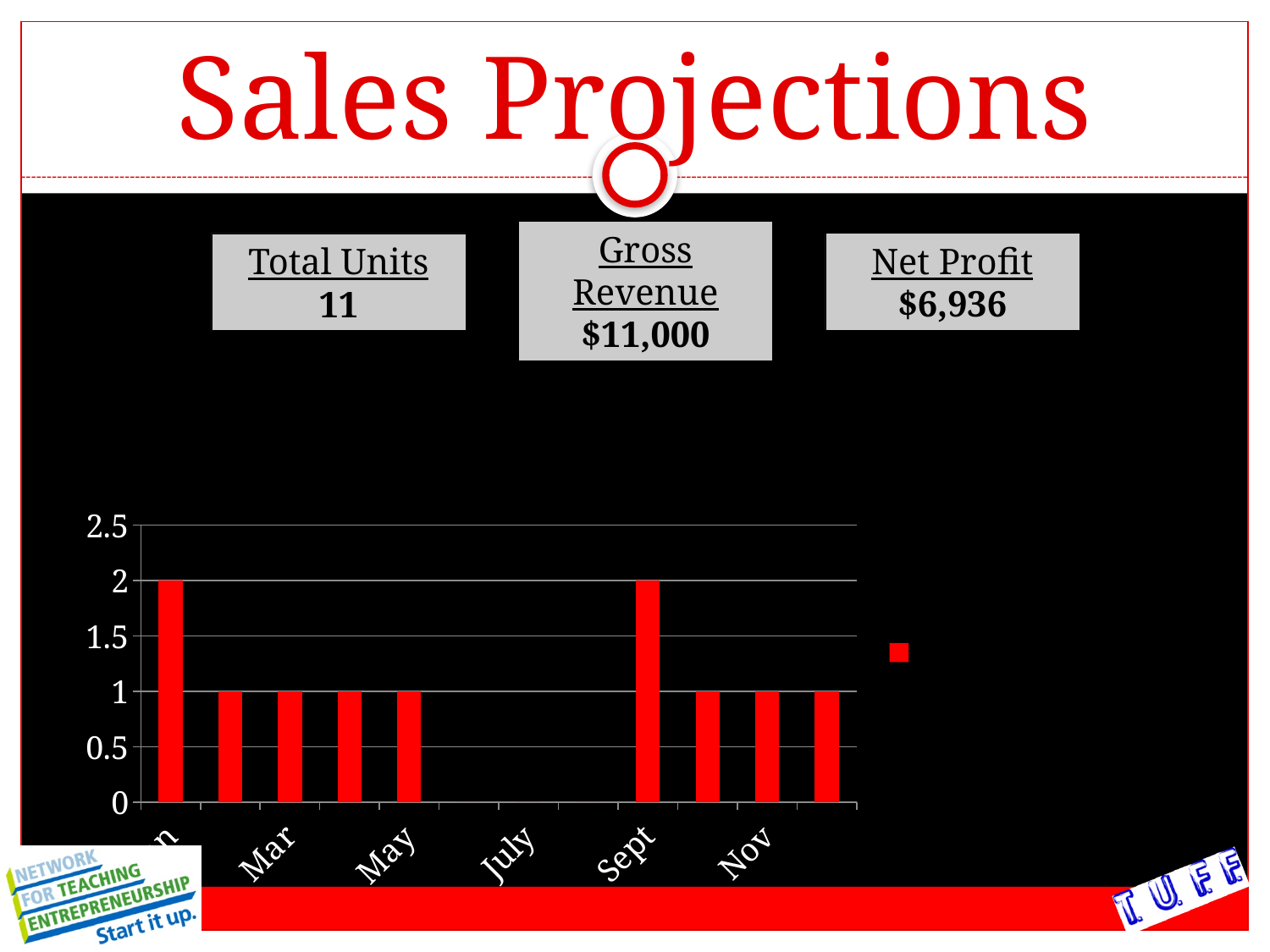
What is the difference between the values for Sept and Nov? 1 What is the value of the bar for Mar? 1 What kind of chart is shown on the slide? bar chart Which of the labeled months has the lowest bar? July What is the value of the bar for July? 0 What colour are the bars in the chart? red What is the value of the bar for May? 1 Which has the larger value, Sept or Mar? Sept How many bars in the chart reach a value of 2? 2 What is the value of the bar for Sept? 2 What is the value of the bar for Nov? 1 Is the value for Sept greater or less than 1.5? greater